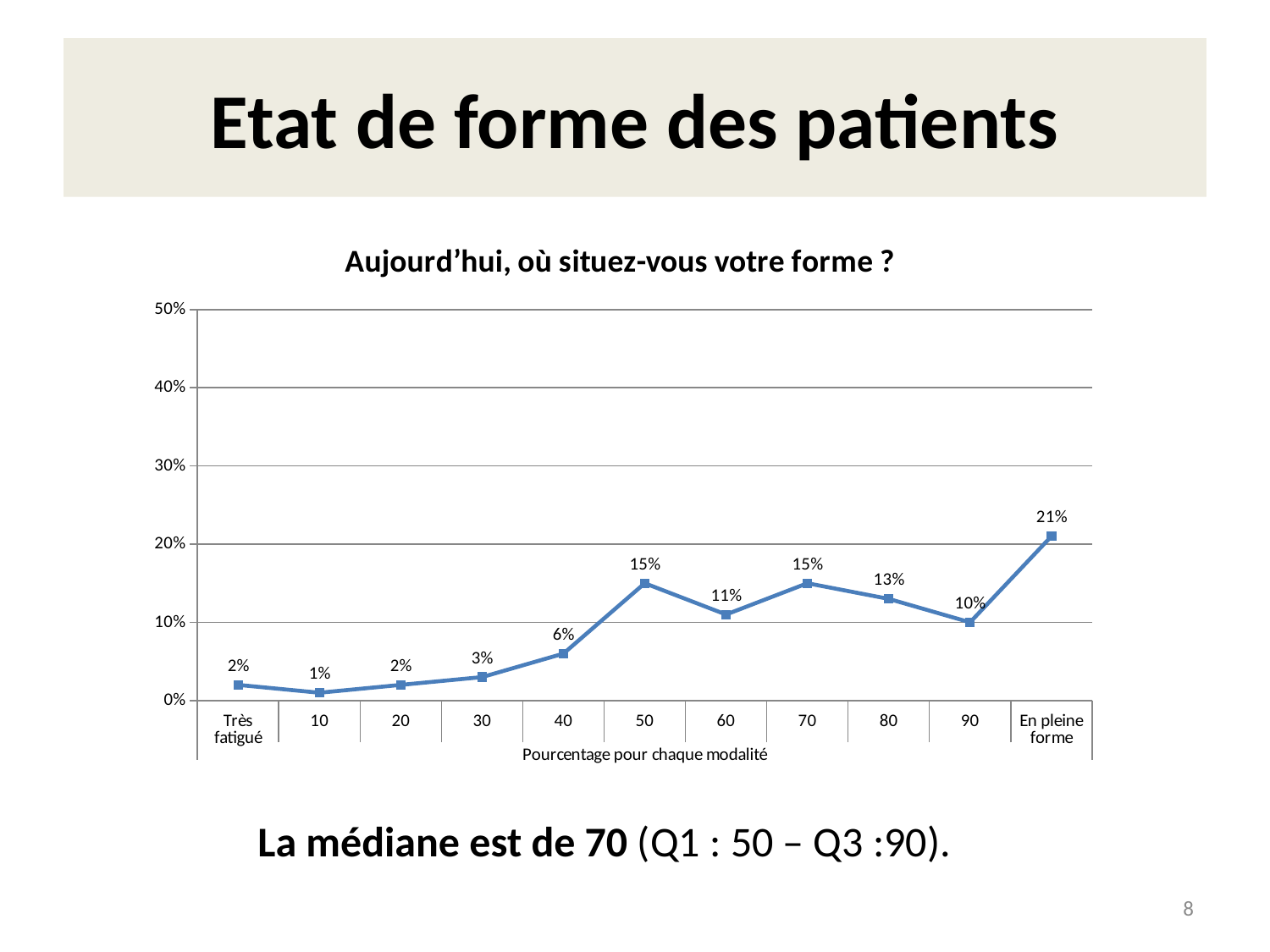
What kind of chart is shown on the slide? line chart What is the value for the category 50? 15% Which is larger, the value for 60 or the value for 80? 80 How many categories are plotted on the x axis? 11 Which category has the highest value? En pleine forme Is the value for 70 greater or less than 10%? greater Which category has the lowest value? 10 What is the value for 'En pleine forme'? 21% What is the difference between the values for 'En pleine forme' and 90? 11% What is the value for 'Très fatigué'? 2% Do the values generally rise or fall from 'Très fatigué' to 'En pleine forme'? rise What is the title of the chart? Aujourd'hui, où situez-vous votre forme ?